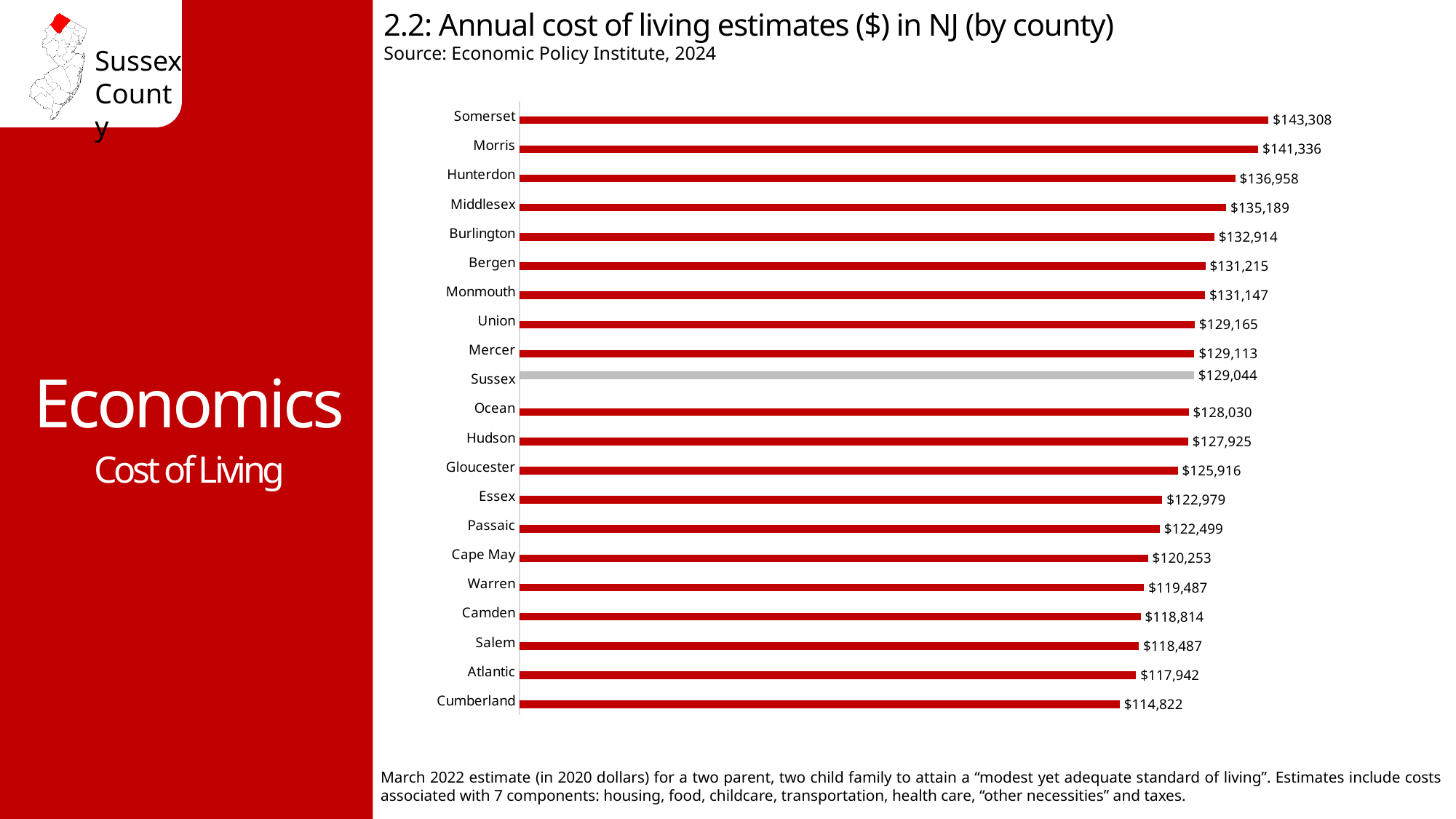
What is the annual cost of living estimate for Somerset County? $143,308 Which county has the lowest annual cost of living estimate? Cumberland Which county has a higher cost of living estimate, Hunterdon or Essex? Hunterdon What is the annual cost of living estimate for Sussex County? $129,044 What is the annual cost of living estimate for Cape May County? $120,253 What type of chart is used to show the cost of living estimates? Bar chart Which county has a higher cost of living estimate, Warren or Gloucester? Gloucester Which county's bar is shown in grey instead of red? Sussex What is the difference between the cost of living estimates for Somerset and Cumberland? $28,486 Which county has the highest annual cost of living estimate? Somerset What is the difference between the cost of living estimates for Morris and Sussex? $12,292 How many counties are shown in the chart? 21